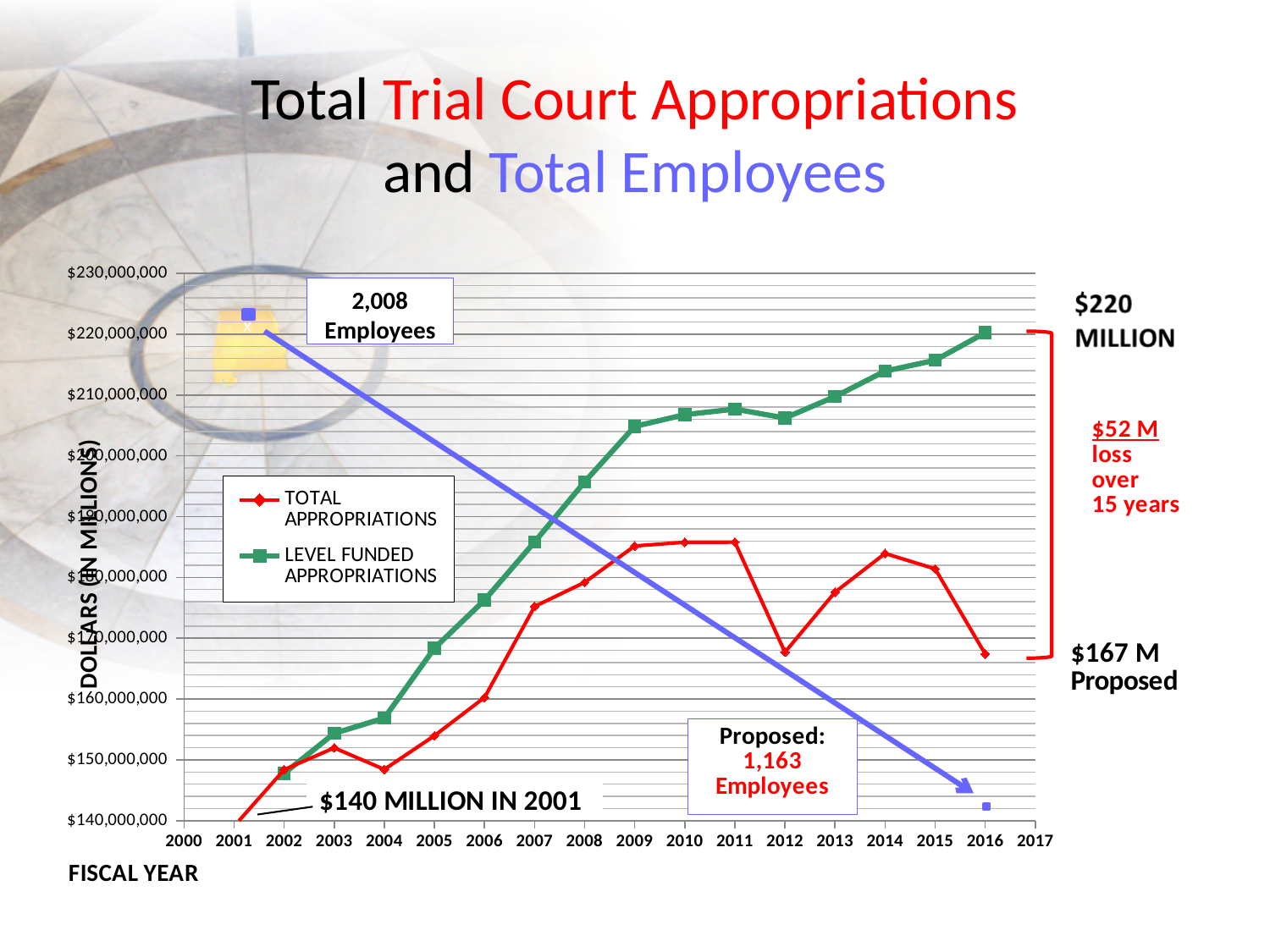
Is the TOTAL APPROPRIATIONS value for 2009 greater or less than $180,000,000? greater What value does the annotation give for the LEVEL FUNDED APPROPRIATIONS line in 2016? $220 MILLION In 2016, which series is higher: TOTAL APPROPRIATIONS or LEVEL FUNDED APPROPRIATIONS? LEVEL FUNDED APPROPRIATIONS How many employees does the 'Proposed' annotation show? 1,163 What kind of chart is shown on the slide? line chart According to the annotation, what was the total appropriation in 2001? $140 MILLION How many series does the chart legend list? 2 What are the two series named in the chart legend? TOTAL APPROPRIATIONS and LEVEL FUNDED APPROPRIATIONS What loss over 15 years does the chart annotation state? $52 M What is the proposed total appropriation for 2016 shown on the chart? $167 M Does the LEVEL FUNDED APPROPRIATIONS line generally rise or fall from 2002 to 2016? rise Is the LEVEL FUNDED APPROPRIATIONS value for 2003 greater or less than $160,000,000? less